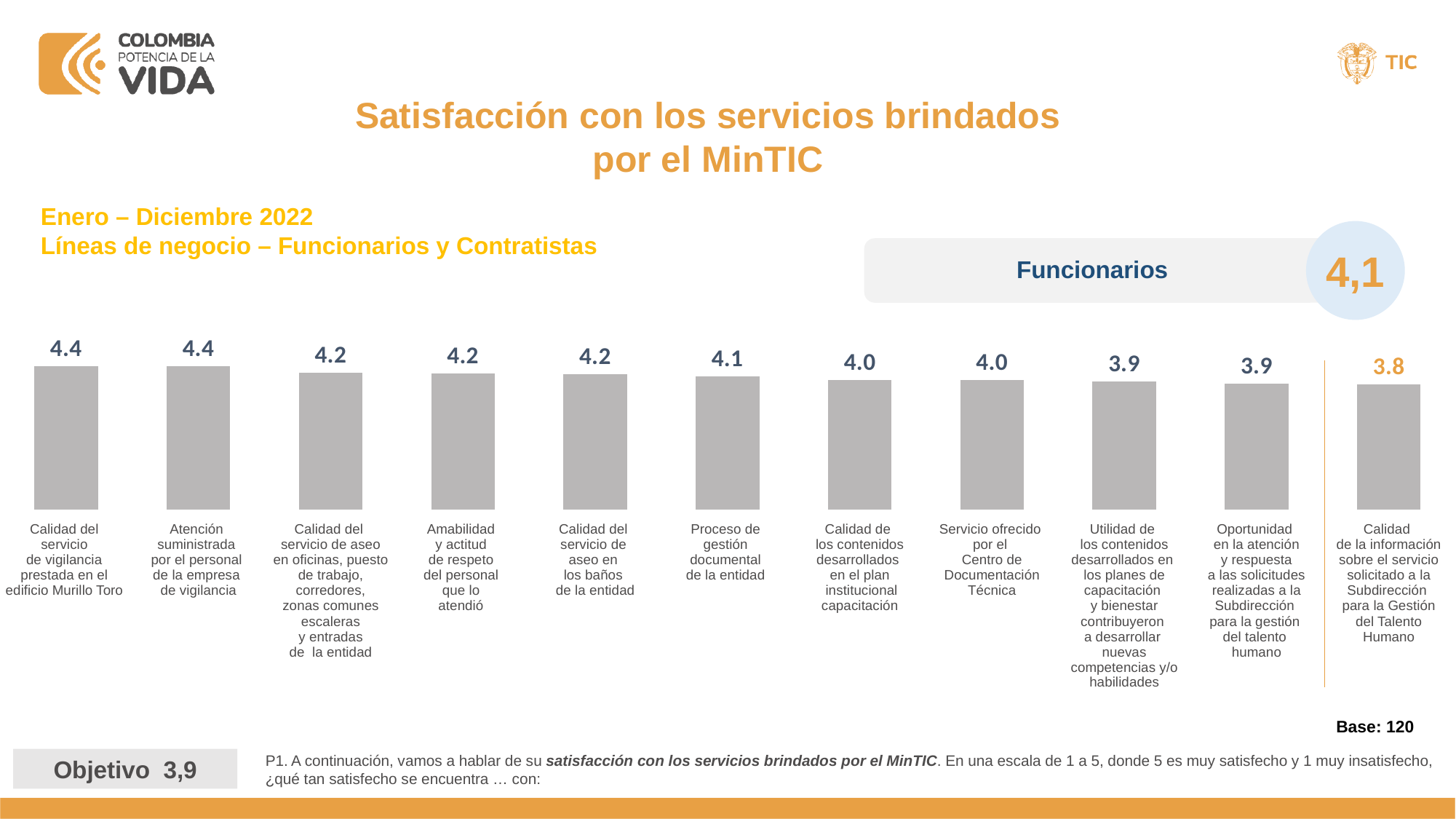
What is the satisfaction value for 'Proceso de gestión documental de la entidad'? 4.1 How many categories (bars) are shown on the chart? 11 What kind of chart is shown on the slide? Bar chart What is the highest satisfaction value shown on the chart? 4.4 Do the values rise or fall from left to right across the chart? Fall Which category has the lowest satisfaction value on the chart? Calidad de la información sobre el servicio solicitado a la Subdirección para la Gestión del Talento Humano What is the difference between the value for 'Calidad del servicio de vigilancia prestada en el edificio Murillo Toro' and the value for 'Oportunidad en la atención y respuesta a las solicitudes realizadas a la Subdirección para la gestión del talento humano'? 0.5 What is the base (number of respondents) indicated on the slide? 120 What is the satisfaction value for 'Calidad de la información sobre el servicio solicitado a la Subdirección para la Gestión del Talento Humano'? 3.8 What overall satisfaction score is shown for 'Funcionarios' in the circle at the top right? 4,1 Which is larger: the value for 'Amabilidad y actitud de respeto del personal que lo atendió' or the value for 'Calidad de los contenidos desarrollados en el plan institucional capacitación'? Amabilidad y actitud de respeto del personal que lo atendió What is the satisfaction value for 'Servicio ofrecido por el Centro de Documentación Técnica'? 4.0